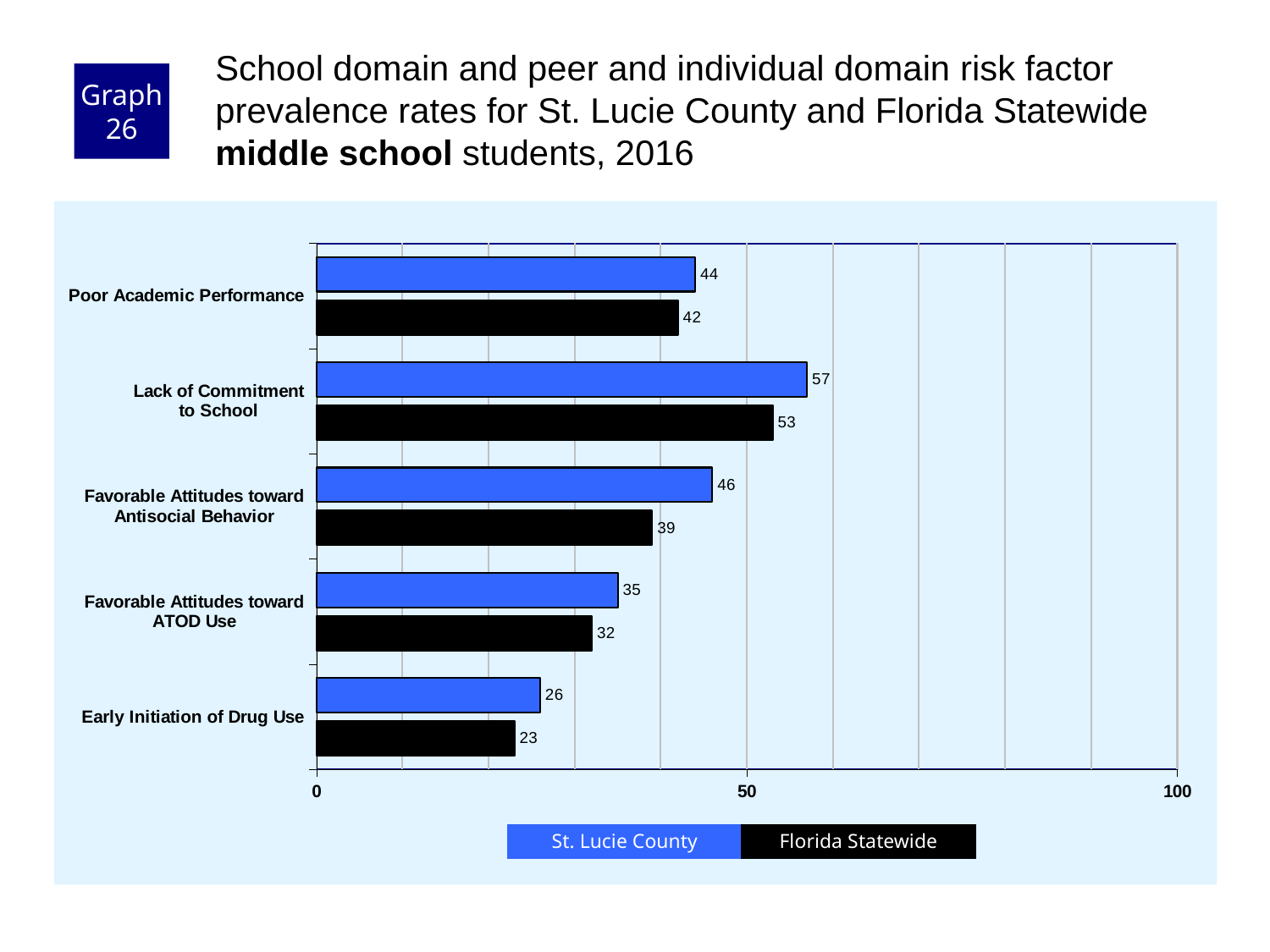
How many risk factors are shown on the chart? 5 What kind of chart is shown on the slide? bar chart What is the Florida Statewide value for Favorable Attitudes toward Antisocial Behavior? 39 Which risk factor has the highest St. Lucie County value? Lack of Commitment to School What is the difference between the St. Lucie County and Florida Statewide values for Lack of Commitment to School? 4 What is the St. Lucie County value for Lack of Commitment to School? 57 What is the Florida Statewide value for Early Initiation of Drug Use? 23 Which is larger for Poor Academic Performance: the St. Lucie County value or the Florida Statewide value? St. Lucie County How many series does the legend list? 2 What is the difference between the St. Lucie County and Florida Statewide values for Favorable Attitudes toward Antisocial Behavior? 7 Which risk factor has the lowest Florida Statewide value? Early Initiation of Drug Use Is the St. Lucie County value for Favorable Attitudes toward ATOD Use greater or less than 50? less